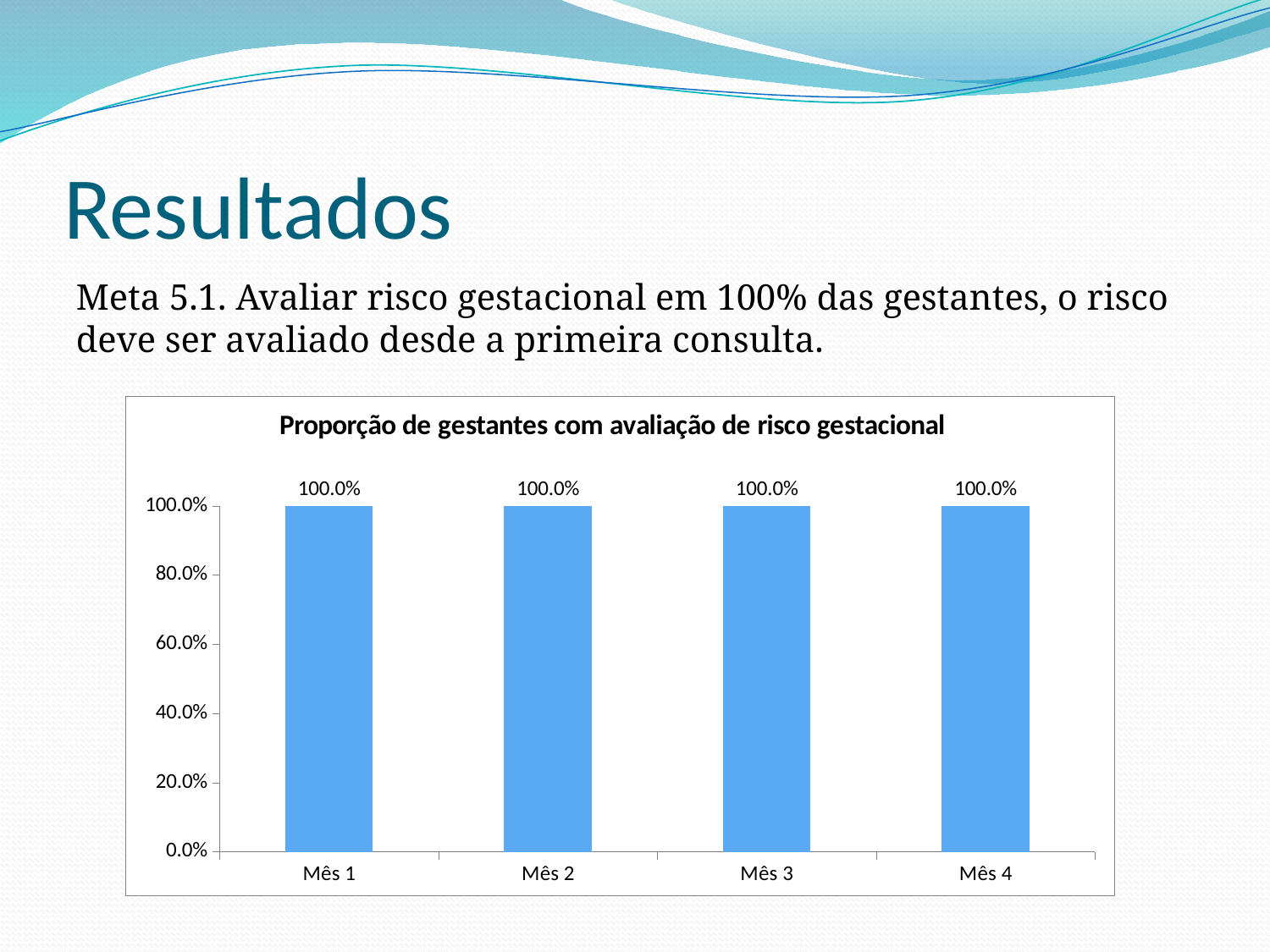
What kind of chart is shown on the slide? bar chart What is the title of the chart? Proporção de gestantes com avaliação de risco gestacional What is the highest value shown on the y axis? 100.0% What is the value for Mês 1? 100.0% Is the value for Mês 2 greater or less than 80.0%? greater Do the values rise, fall or stay the same from Mês 1 to Mês 4? stay the same How many categories are shown on the x axis? 4 What is the value for Mês 3? 100.0% What is the value for Mês 4? 100.0% What is the difference between the values for Mês 2 and Mês 4? 0.0%